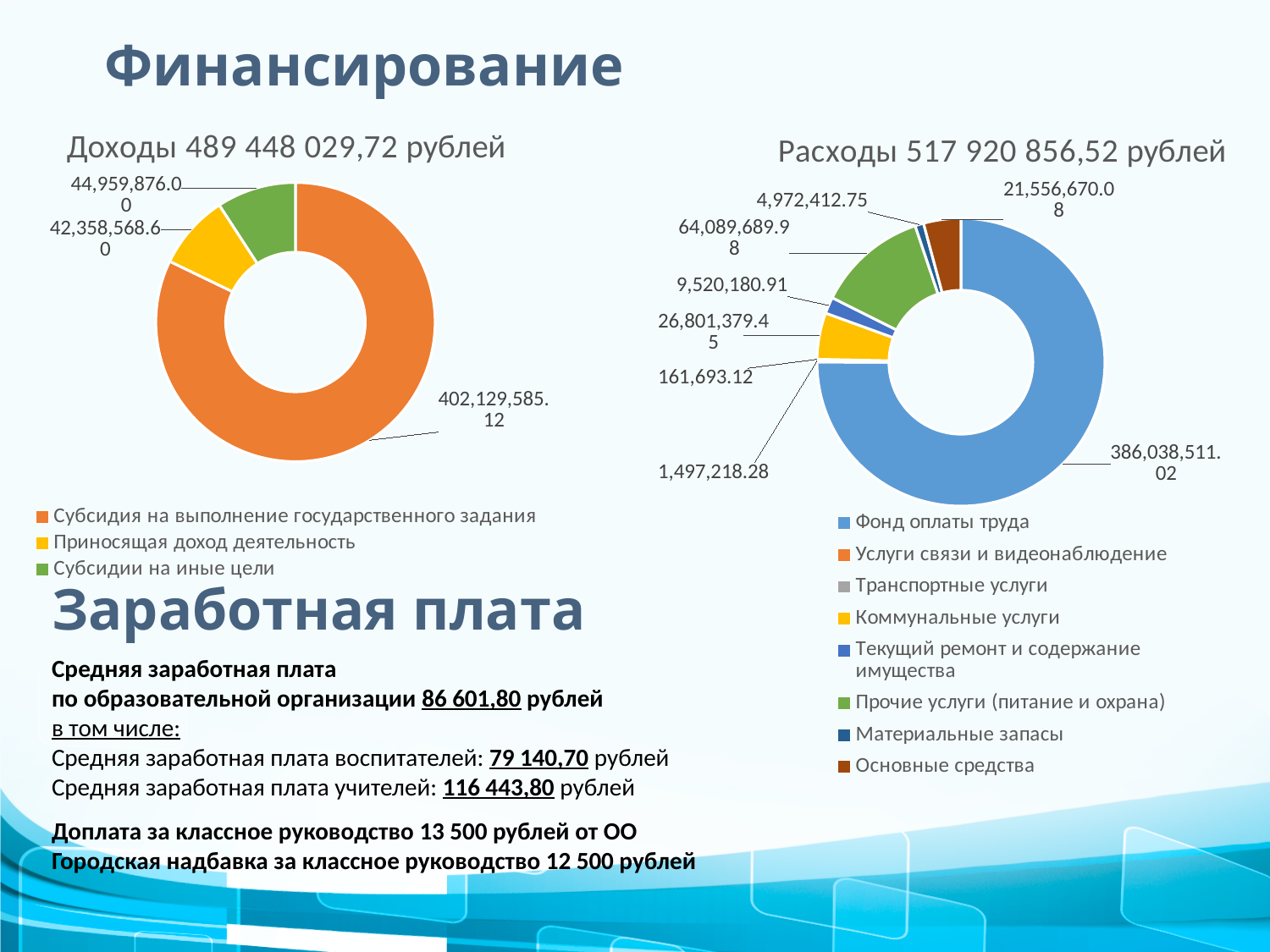
How many categories does the legend of the 'Расходы' chart list? 8 How many categories does the legend of the 'Доходы' chart list? 3 In the 'Расходы' chart, which category has the largest value? Фонд оплаты труда In the 'Расходы' chart, what is the value for 'Фонд оплаты труда'? 386,038,511.02 In the 'Расходы' chart, which is larger: 'Основные средства' or 'Текущий ремонт и содержание имущества'? Основные средства In the 'Доходы' chart, what is the value for 'Субсидия на выполнение государственного задания'? 402,129,585.12 In the 'Доходы' chart, which category has the smallest value? Приносящая доход деятельность In the 'Доходы' chart, what is the difference between 'Субсидии на иные цели' and 'Приносящая доход деятельность'? 2,601,307.40 In the 'Расходы' chart, what is the value for 'Прочие услуги (питание и охрана)'? 64,089,689.98 In the 'Расходы' chart, what is the value for 'Коммунальные услуги'? 26,801,379.45 In the 'Доходы' chart, what is the value for 'Субсидии на иные цели'? 44,959,876.00 What type of chart is used for the 'Доходы' chart on the left? Doughnut chart